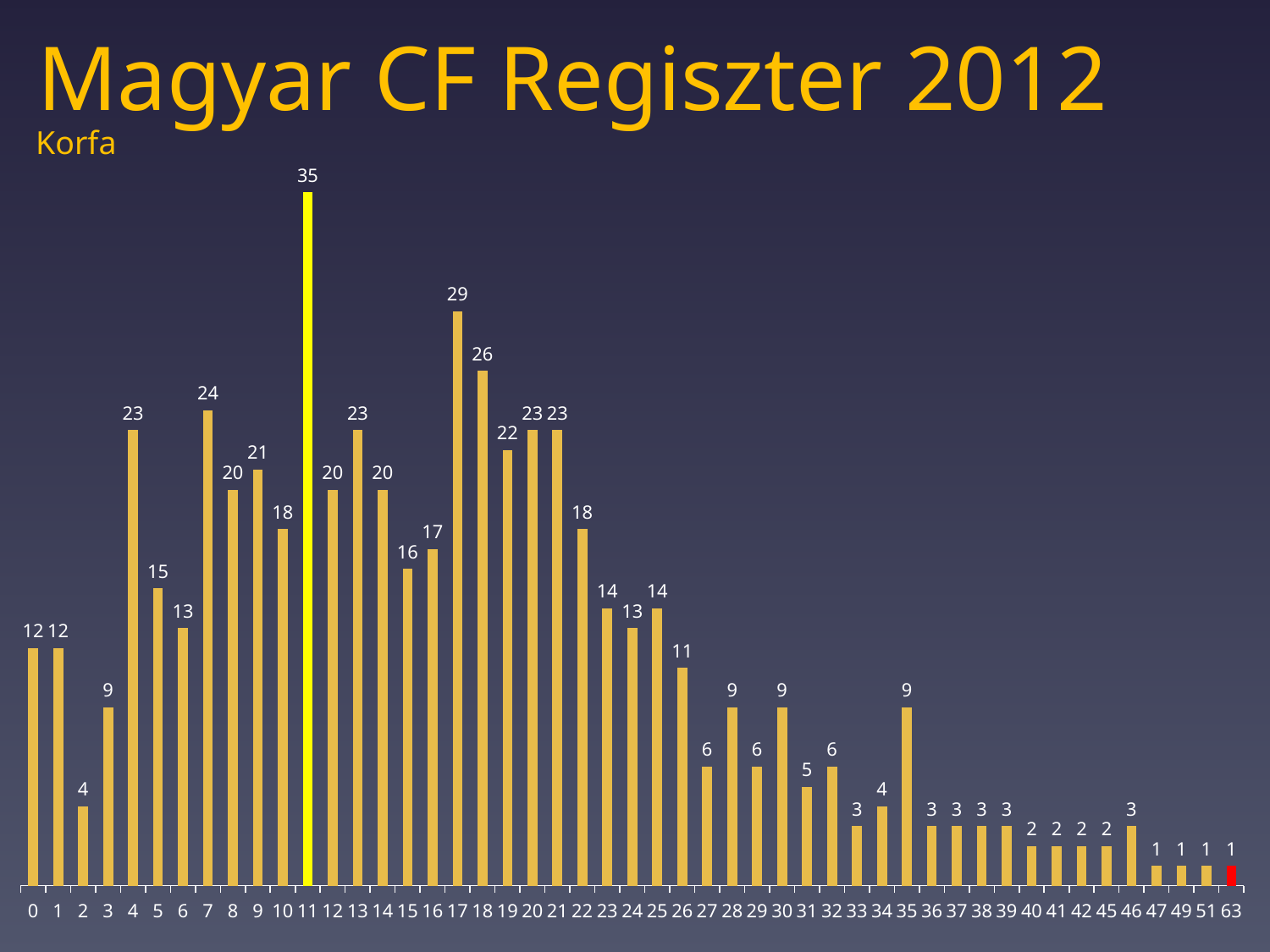
What is the value for category 17? 29 What kind of chart is shown on the slide? bar chart What is the value for category 35? 9 What is the title of the chart? Magyar CF Regiszter 2012 What is the difference between the values for category 11 and category 17? 6 What is the value for category 2? 4 Which has the larger value, category 4 or category 7? 7 Which category has the highest value? 11 What is the difference between the values for category 18 and category 19? 4 Which category's bar is coloured red? 63 What is the value for category 63? 1 How many categories are shown on the x axis? 49